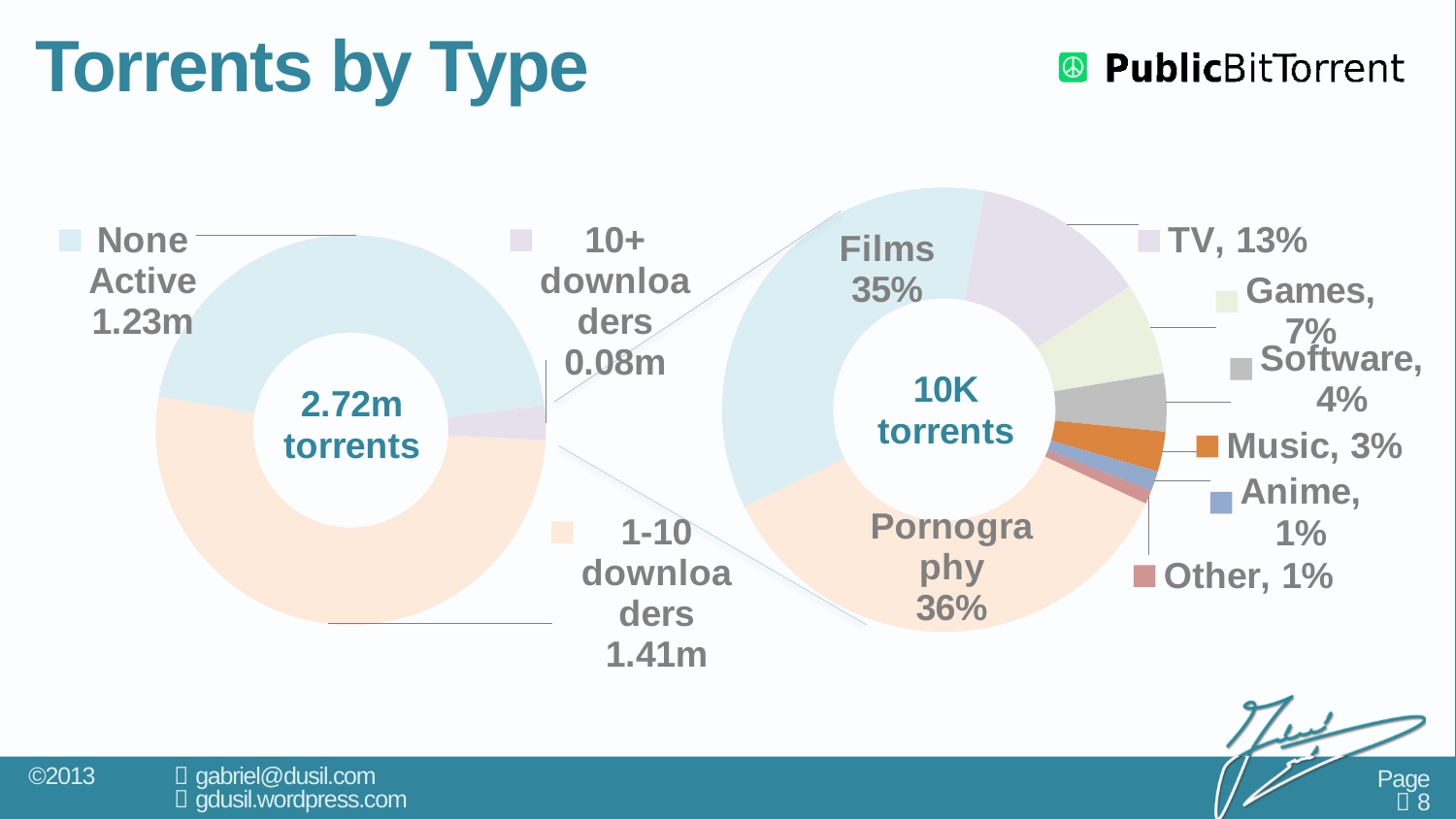
In the right donut chart labelled "10K torrents", which is larger, Games or Software? Games In the right donut chart labelled "10K torrents", what share is Films? 35% In the left donut chart labelled "2.72m torrents", what is the value for 1-10 downloaders? 1.41m In the left donut chart labelled "2.72m torrents", what is the value for None Active? 1.23m In the left donut chart labelled "2.72m torrents", what is the difference between 1-10 downloaders and None Active? 0.18m What type of chart is used on this slide? Pie (donut) chart In the right donut chart labelled "10K torrents", how many categories are shown? 8 In the left donut chart labelled "2.72m torrents", which category has the smallest value? 10+ downloaders In the right donut chart labelled "10K torrents", what share is TV? 13% In the left donut chart labelled "2.72m torrents", how many categories are shown? 3 In the right donut chart labelled "10K torrents", what is the difference between the Pornography and TV shares? 23% In the right donut chart labelled "10K torrents", which category has the largest share? Pornography